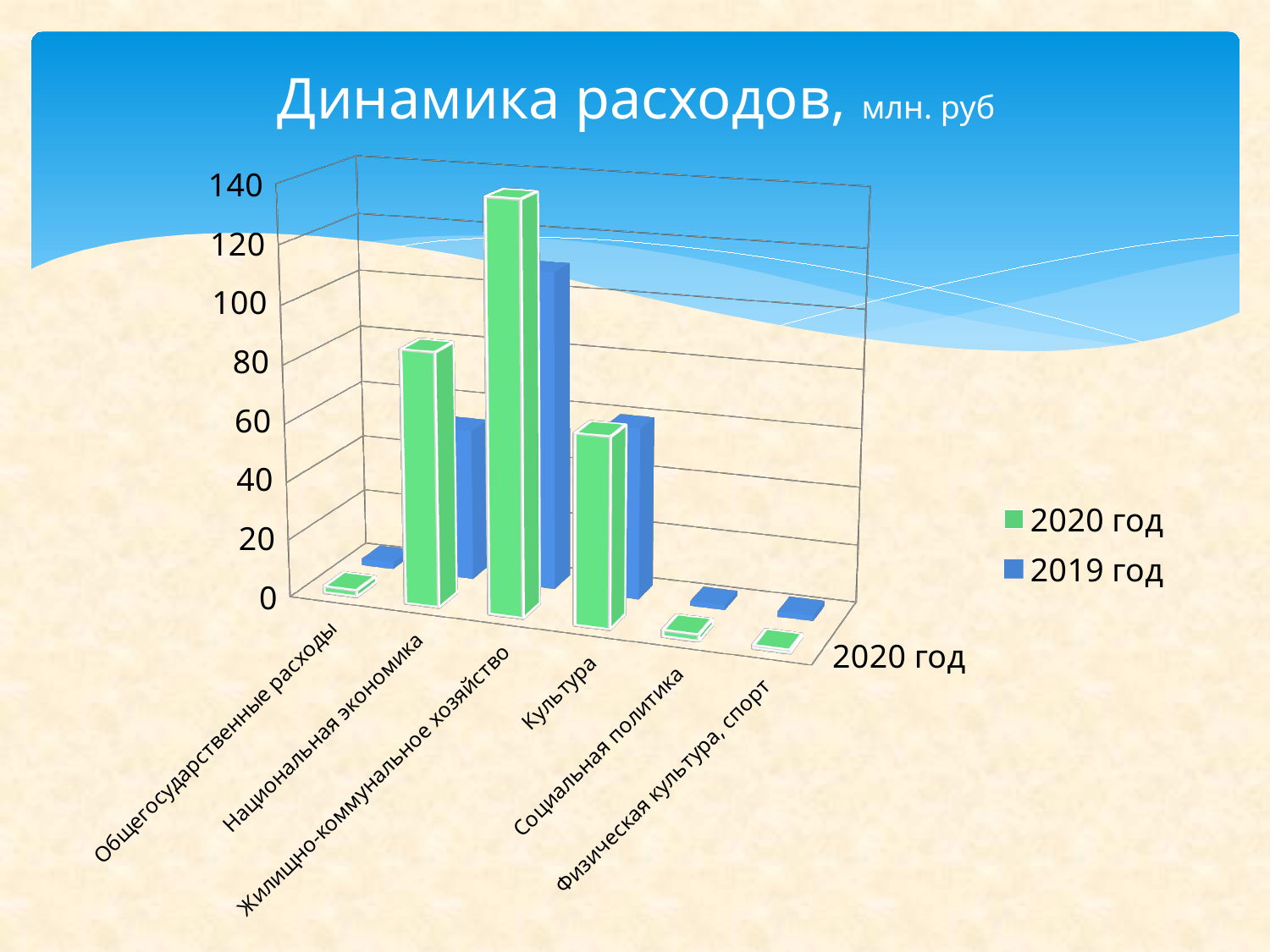
Is the 2020 год value for Социальная политика greater or less than 20? less How many series does the legend list? 2 Is the 2020 год value for Жилищно-коммунальное хозяйство greater or less than 120? greater What kind of chart is shown on the slide? bar chart Which colour represents the 2019 год series in the legend? blue Which category has the highest value for 2020 год? Жилищно-коммунальное хозяйство How many expenditure categories are shown on the x axis? 6 What is the title of the chart? Динамика расходов, млн. руб Which is larger for 2019 год: Жилищно-коммунальное хозяйство or Культура? Жилищно-коммунальное хозяйство Is the 2020 год value for Общегосударственные расходы greater or less than 20? less Which category has the highest value for 2019 год? Жилищно-коммунальное хозяйство Which is larger for 2020 год: Национальная экономика or Культура? Национальная экономика